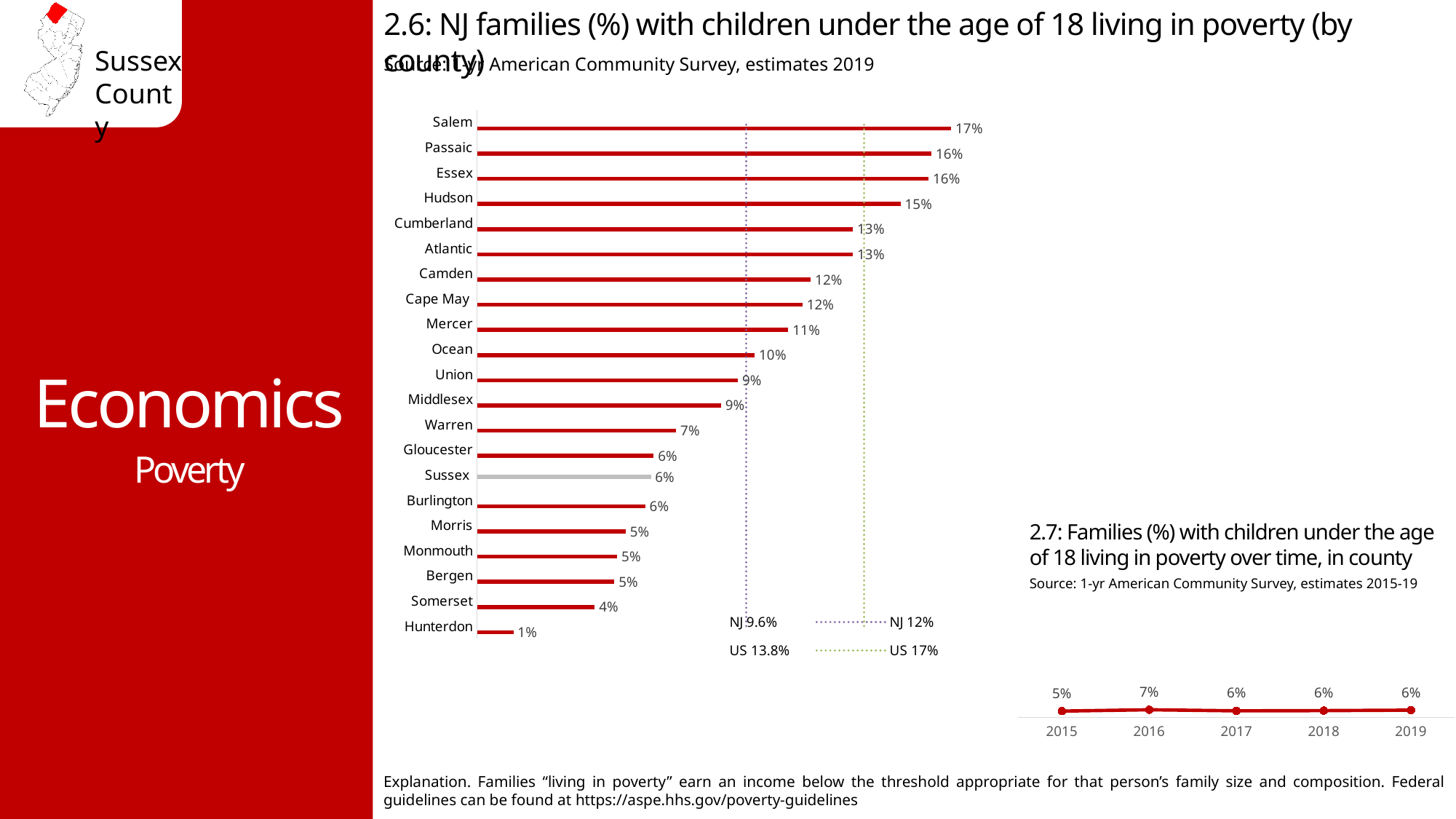
In chart 2.6 (by county), which county has the highest value? Salem In chart 2.7 (over time, in county), which year has the highest value? 2016 What kind of chart is chart 2.6 (by county)? Bar chart In chart 2.6 (by county), how many counties are shown? 21 In chart 2.6 (by county), what is the value for Hudson? 15% In chart 2.6 (by county), which is larger, the value for Mercer or the value for Warren? Mercer In chart 2.7 (over time, in county), how many years are plotted? 5 In chart 2.7 (families in poverty over time, in county), what is the value for 2016? 7% In chart 2.6 (by county), which county has the lowest value? Hunterdon In chart 2.6 (by county), what is the difference between Salem and Hunterdon? 16% In chart 2.6 (NJ families with children under 18 living in poverty by county), what is the value for Sussex? 6%